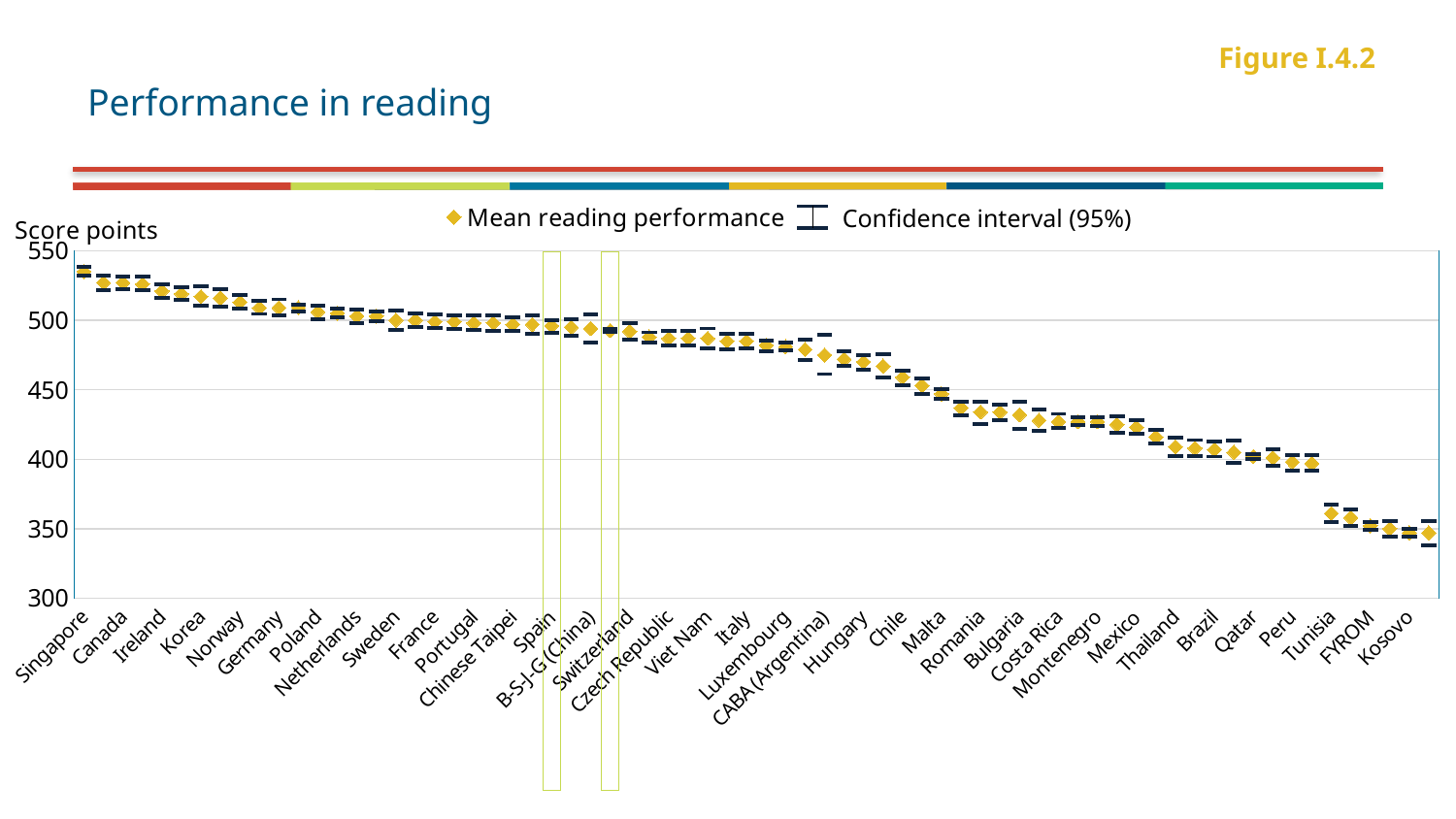
What kind of chart is shown on the slide? scatter chart Is the mean reading performance for Hungary greater or less than 450? greater What is the label on the vertical axis? Score points What is the title of the chart? Performance in reading Do the mean reading performance values rise or fall from left to right along the x axis? fall Which country has the highest mean reading performance? Singapore Which country has the lowest mean reading performance? Kosovo Is the mean reading performance for Singapore greater or less than 500? greater How many entries does the legend list? 2 Is the mean reading performance for Mexico greater or less than 450? less Which has a higher mean reading performance, Canada or Chile? Canada